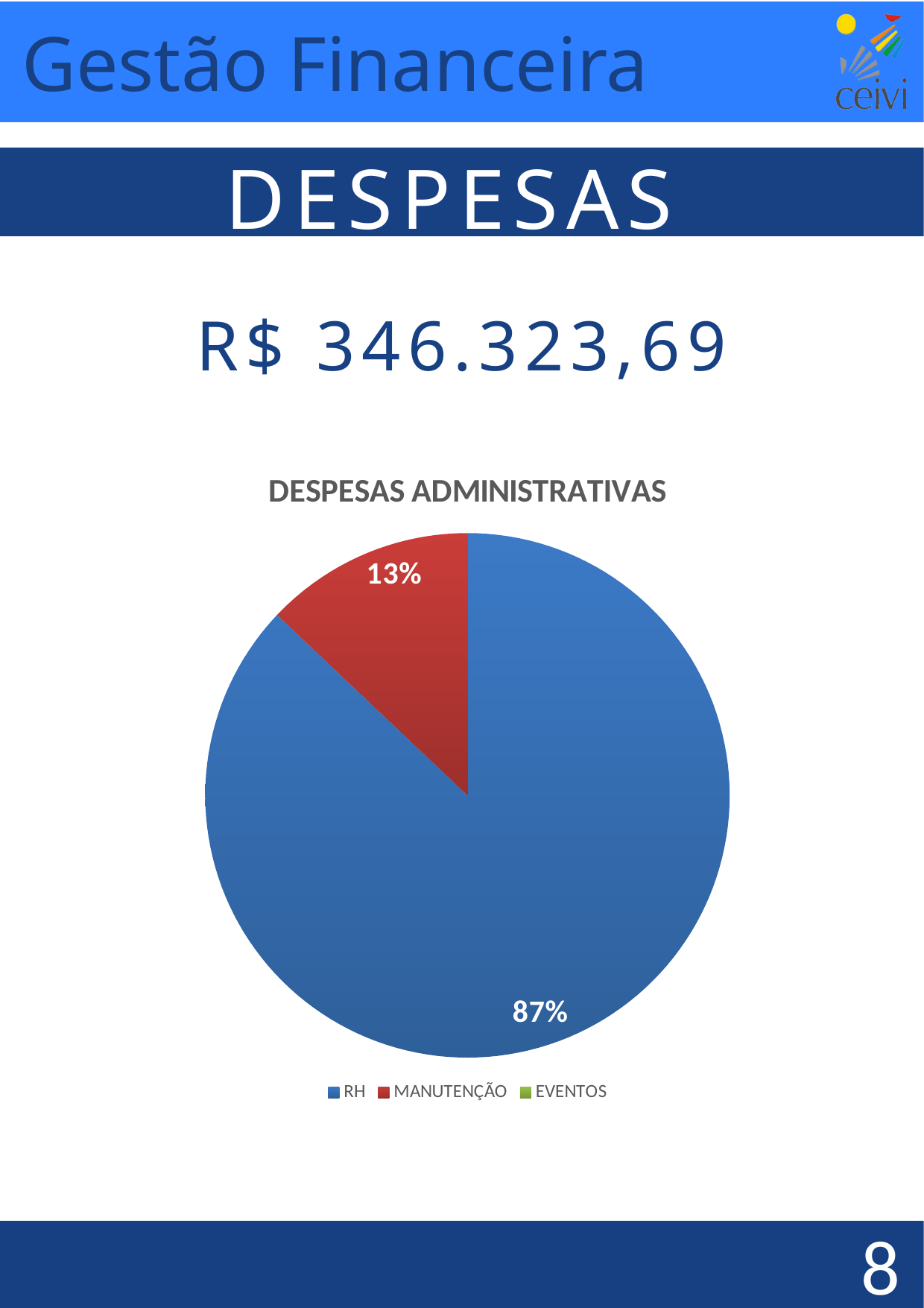
What colour is the RH slice? blue Which of the two labelled slices is larger, RH or MANUTENÇÃO? RH What share of the pie does MANUTENÇÃO represent? 13% How many entries does the legend list? 3 What kind of chart is shown on the slide? pie chart What is the difference in percentage points between the RH slice and the MANUTENÇÃO slice? 74 Which legend entry has no visible slice in the pie? EVENTOS What is the title of the chart? DESPESAS ADMINISTRATIVAS Which category has the largest slice of the pie? RH What total amount of expenses is printed above the chart? R$ 346.323,69 What share of the pie does RH represent? 87%